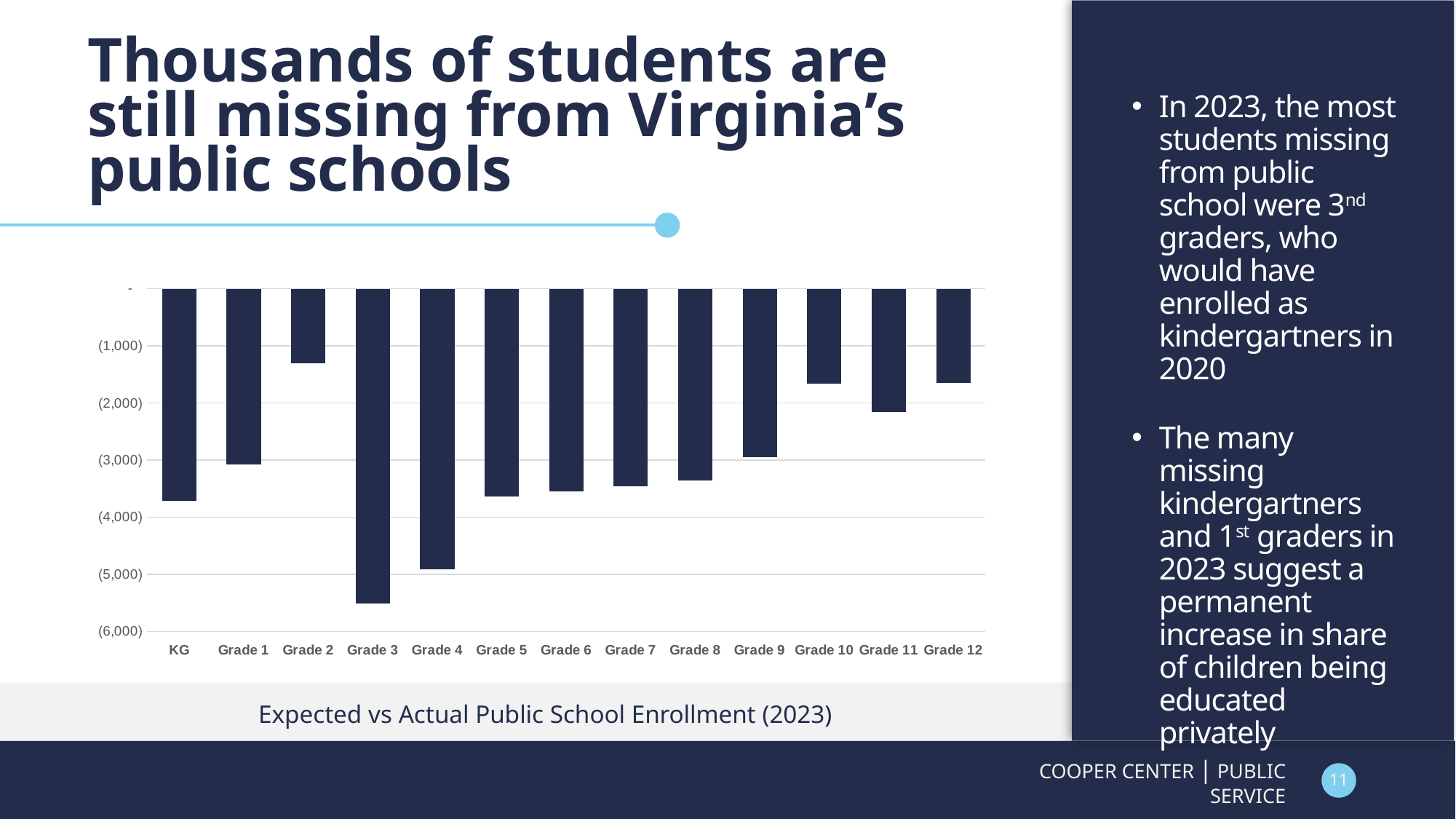
Which bar extends further below zero, Grade 10 or Grade 11? Grade 11 Is the value for Grade 2 greater or less than (2,000)? greater Which bar extends further below zero, KG or Grade 1? KG Which grade has the shortest bar (the fewest students missing) in the chart? Grade 2 What kind of chart is shown on the slide? bar chart How many grade categories are plotted on the x axis of the chart? 13 Which grade has the longest bar (the most students missing) in the chart? Grade 3 Which bar extends further below zero, Grade 3 or Grade 4? Grade 3 What caption appears below the chart? Expected vs Actual Public School Enrollment (2023) Is the value for KG greater or less than (3,000)? less Is the value for Grade 3 greater or less than (5,000)? less From Grade 3 to Grade 10, do the bars generally get longer or shorter? shorter